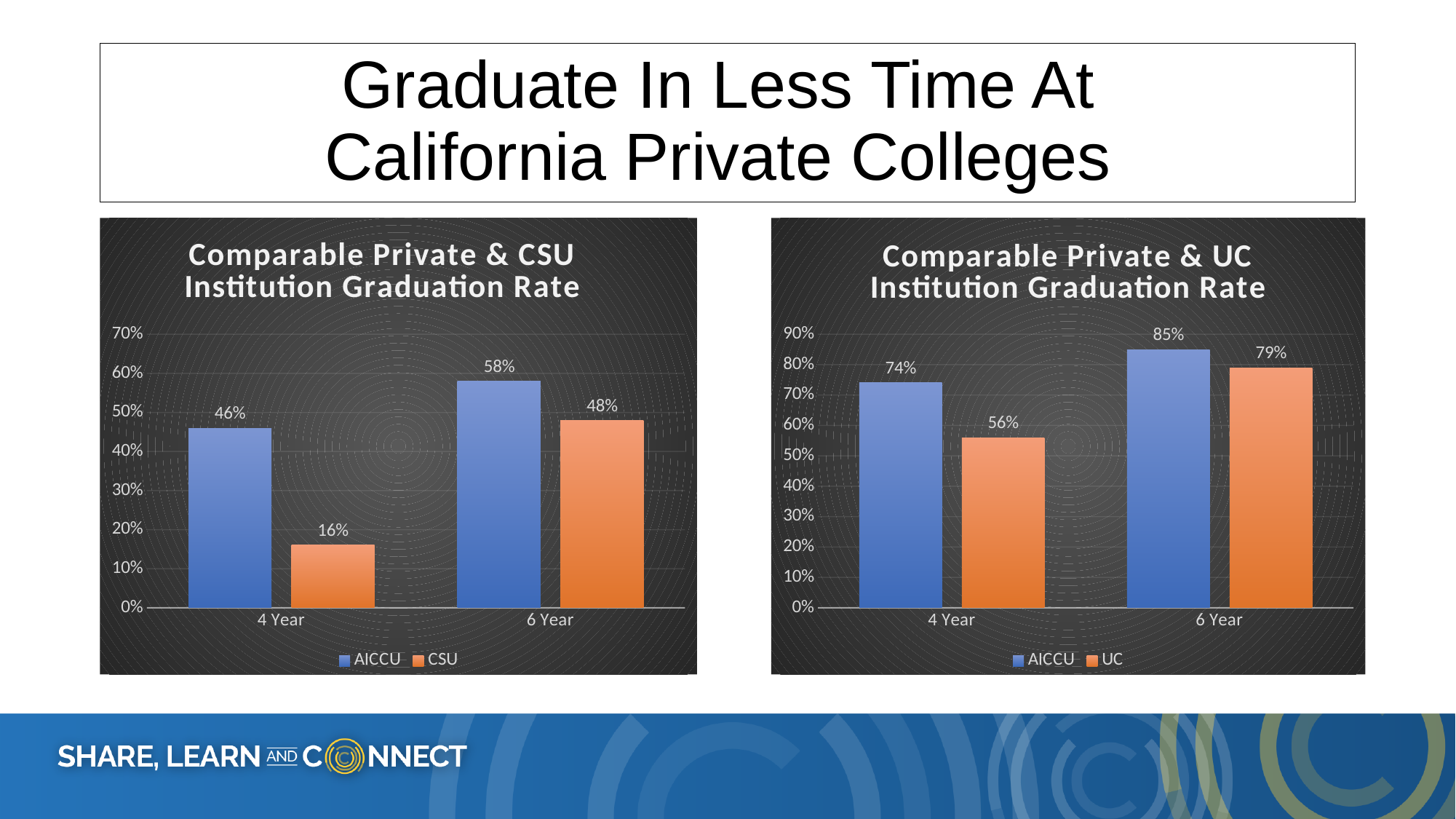
In the 'Comparable Private & UC Institution Graduation Rate' chart, which bar has the highest value? AICCU, 6 Year In the 'Comparable Private & UC Institution Graduation Rate' chart, what is the difference between the AICCU and UC values for 6 Year? 6% In the 'Comparable Private & CSU Institution Graduation Rate' chart, what is the difference between the AICCU and CSU values for 4 Year? 30% In the 'Comparable Private & CSU Institution Graduation Rate' chart, what is the AICCU value for 4 Year? 46% What kind of chart is the 'Comparable Private & UC Institution Graduation Rate' chart? Bar chart How many series does the legend of the 'Comparable Private & CSU Institution Graduation Rate' chart list? 2 In the 'Comparable Private & UC Institution Graduation Rate' chart, what is the UC value for 4 Year? 56% In the 'Comparable Private & UC Institution Graduation Rate' chart, what is the AICCU value for 6 Year? 85% In the 'Comparable Private & CSU Institution Graduation Rate' chart, does the AICCU value rise or fall from 4 Year to 6 Year? Rise In the 'Comparable Private & CSU Institution Graduation Rate' chart, which bar has the lowest value? CSU, 4 Year In the 'Comparable Private & UC Institution Graduation Rate' chart, which is larger for 4 Year: AICCU or UC? AICCU In the 'Comparable Private & CSU Institution Graduation Rate' chart, what is the CSU value for 6 Year? 48%